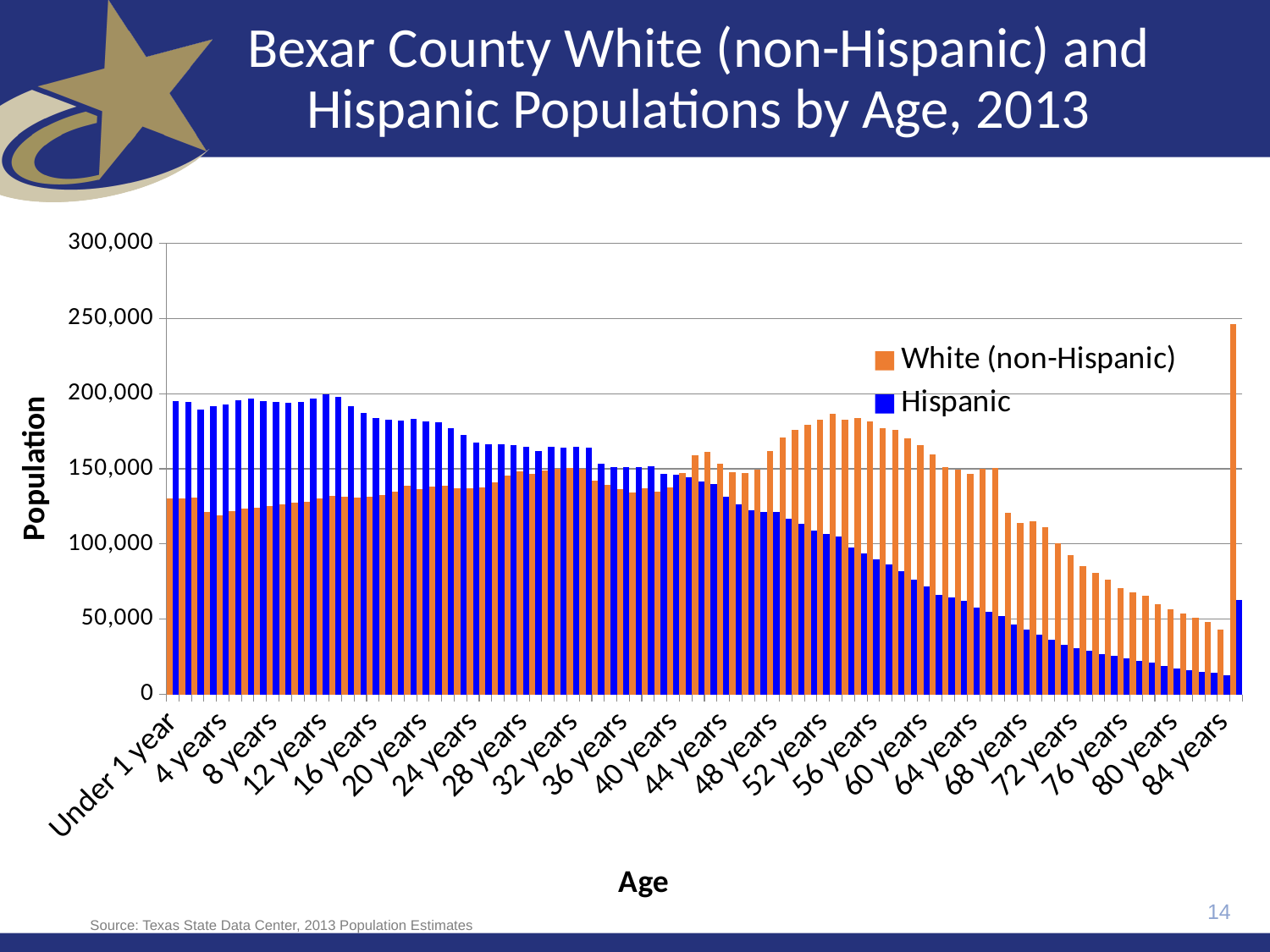
Is the Hispanic value for 84 years greater or less than 50,000? less At 4 years, which series has the larger value, White (non-Hispanic) or Hispanic? Hispanic Is the White (non-Hispanic) value for Under 1 year greater or less than 150,000? less Is the Hispanic value for Under 1 year greater or less than 150,000? greater How many series does the legend list? 2 What kind of chart is shown on the slide? bar chart At 56 years, which series has the larger value, White (non-Hispanic) or Hispanic? White (non-Hispanic) What is the title of the chart? Bexar County White (non-Hispanic) and Hispanic Populations by Age, 2013 Which two series are listed in the legend? White (non-Hispanic) and Hispanic Do the Hispanic values rise or fall along the x axis from 16 years to 84 years? fall